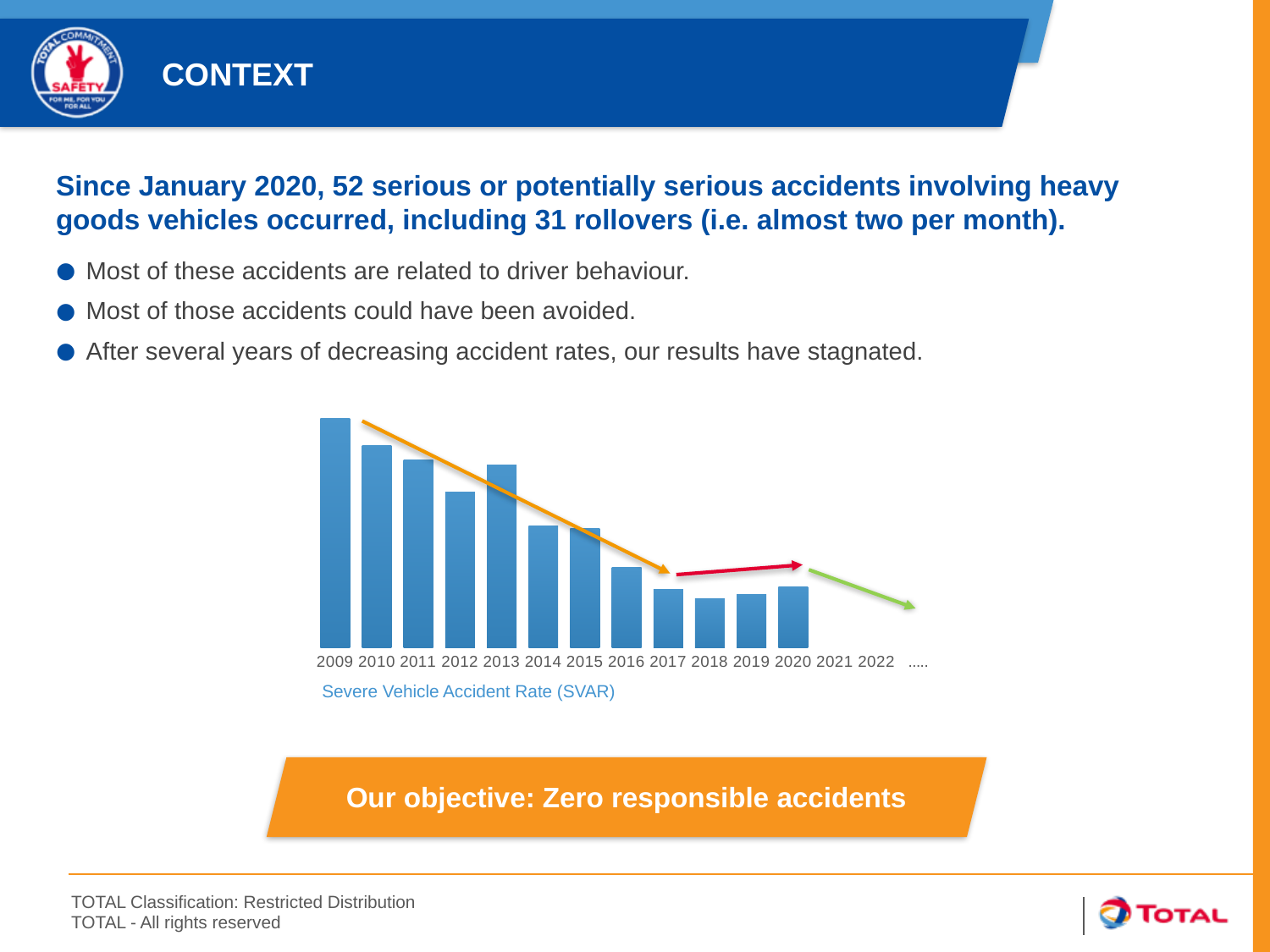
Do the bar values generally rise or fall from 2009 to 2020? fall Which is larger, the bar for 2012 or the bar for 2013? 2013 Which year has the highest bar in the chart? 2009 What is the first year shown on the x axis of the chart? 2009 What kind of chart is shown on the slide? bar chart Which is larger, the bar for 2009 or the bar for 2020? 2009 What is the title or caption of the chart? Severe Vehicle Accident Rate (SVAR) Which is larger, the bar for 2011 or the bar for 2017? 2011 How many years have a bar plotted in the chart? 12